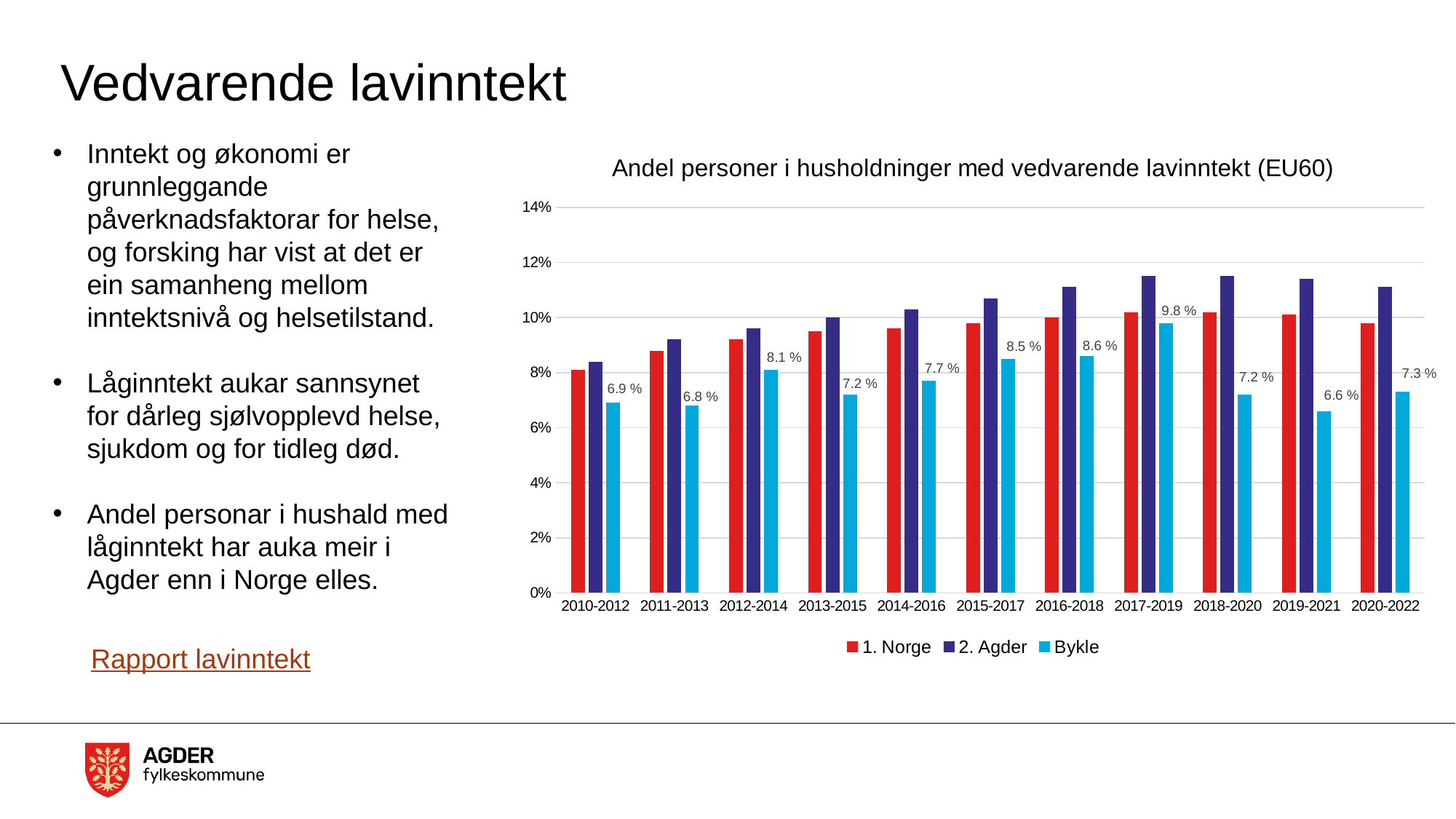
What is the value for Bykle in 2010-2012? 6.9 % What is the value for Bykle in 2017-2019? 9.8 % In 2017-2019, which is larger: the value for 1. Norge or for 2. Agder? 2. Agder What kind of chart is shown on the slide? Bar chart What is the difference between the Bykle values for 2017-2019 and 2019-2021? 3.2 percentage points Is the value for 1. Norge in 2010-2012 greater or less than 10%? less How many periods are shown on the x axis? 11 How many series does the legend list? 3 In which period is the Bykle value lowest? 2019-2021 In which period is the Bykle value highest? 2017-2019 Is the value for 2. Agder in 2017-2019 greater or less than 10%? greater What is the value for Bykle in 2019-2021? 6.6 %